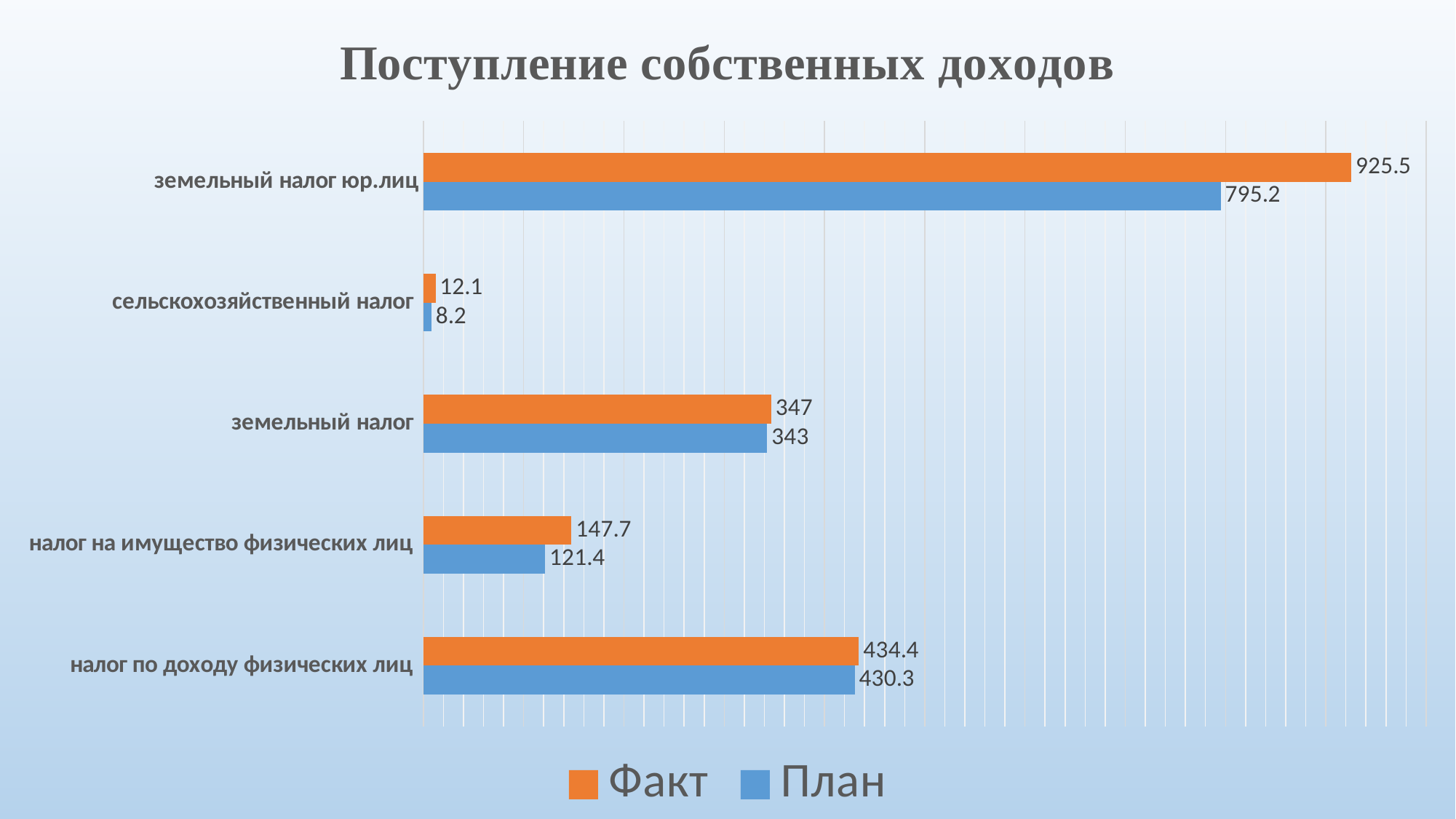
What is the difference between the Факт and План values for налог на имущество физических лиц? 26.3 How many categories are shown on the chart? 5 What is the План value for налог на имущество физических лиц? 121.4 What is the title of the chart? Поступление собственных доходов What is the План value for сельскохозяйственный налог? 8.2 What is the Факт value for земельный налог юр.лиц? 925.5 Which is larger for налог по доходу физических лиц: the Факт value or the План value? Факт Which category has the lowest План value? сельскохозяйственный налог Which category has the highest Факт value? земельный налог юр.лиц How many series does the legend list? 2 What is the difference between the Факт and План values for земельный налог юр.лиц? 130.3 What kind of chart is shown on the slide? bar chart